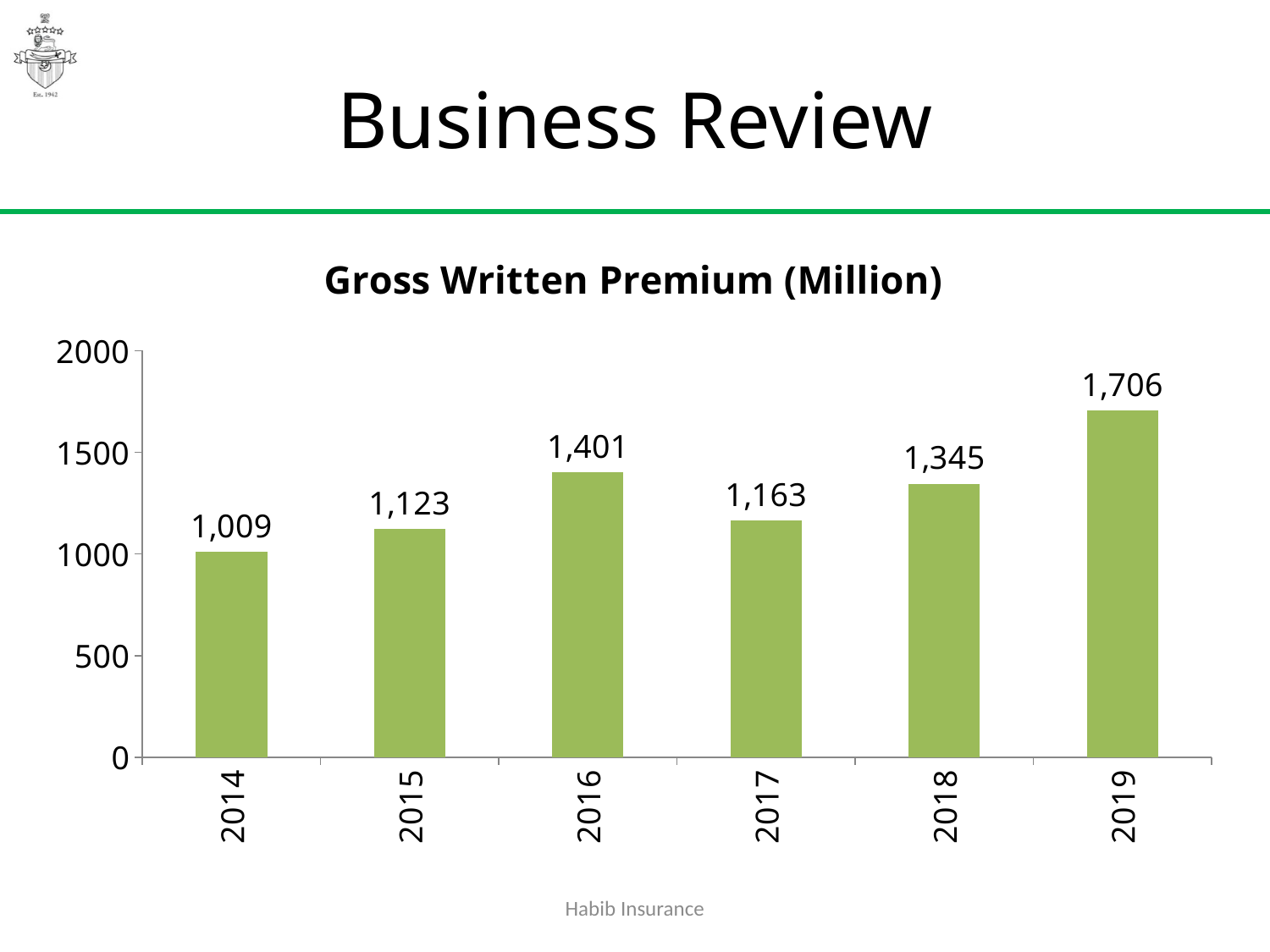
What kind of chart is shown on the slide? Bar chart Which year has the highest Gross Written Premium? 2019 Is the Gross Written Premium for 2019 greater or less than 1500? greater Which year has a larger Gross Written Premium, 2015 or 2017? 2017 What is the Gross Written Premium for 2016? 1,401 What is the Gross Written Premium for 2018? 1,345 What is the title of the chart? Gross Written Premium (Million) Which year has the lowest Gross Written Premium? 2014 What is the difference between the Gross Written Premium in 2016 and 2017? 238 What is the Gross Written Premium for 2014? 1,009 How many years are shown in the chart? 6 What is the difference between the Gross Written Premium in 2019 and 2018? 361